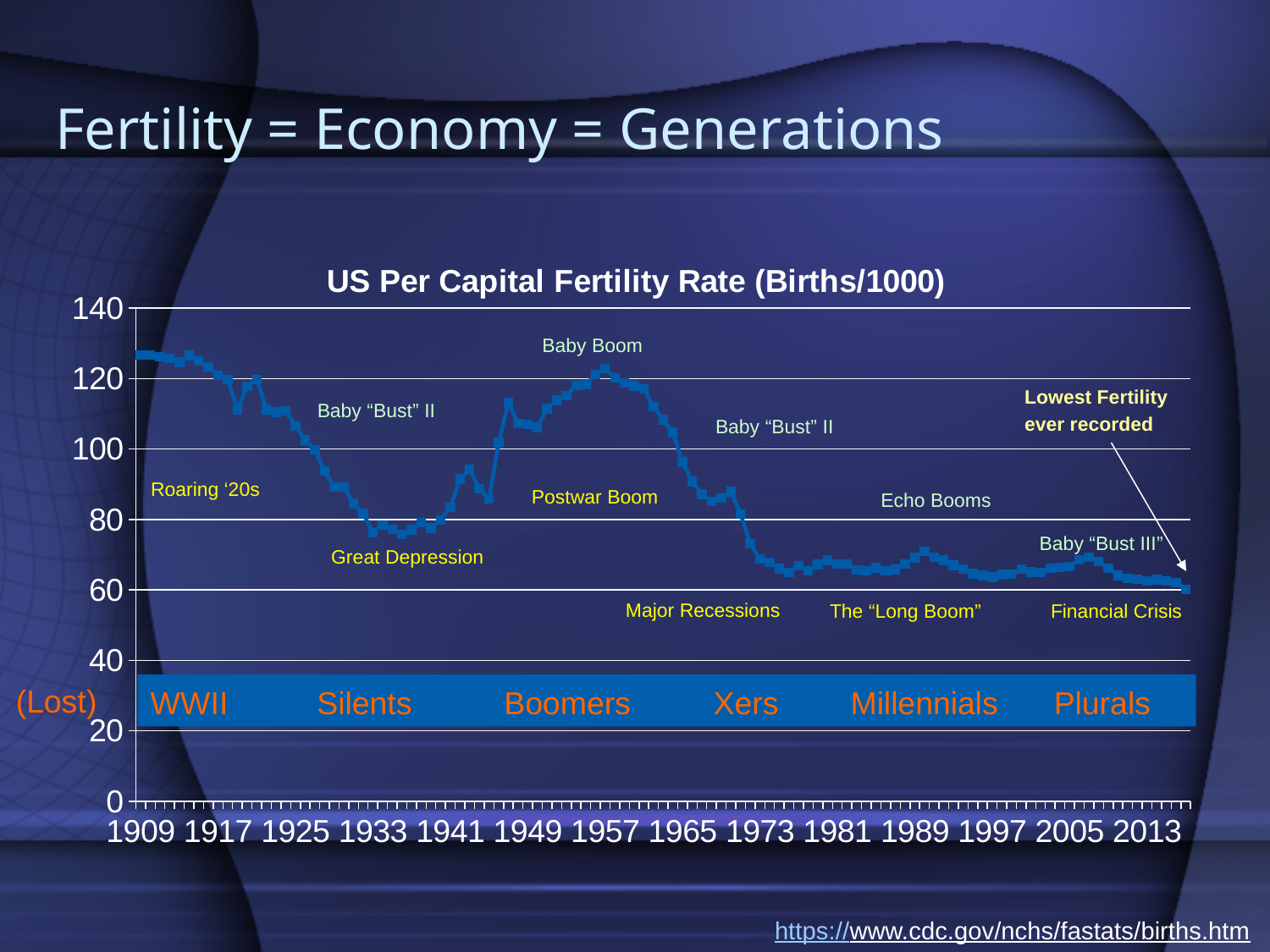
Which is larger, the fertility rate in 1957 or the fertility rate in 1973? 1957 Is the fertility rate at the Great Depression low point (around 1933-1936) greater or less than 80? less Which annotation labels the peak of the line around 1957? Baby Boom Does the fertility rate rise or fall between 1957 and 1973? fall What kind of chart is shown on the slide? line chart Is the fertility rate in 2013 greater or less than 80? less Does the fertility rate rise or fall between 1936 and 1957? rise Is the fertility rate in 1909 greater or less than 120? greater What is the title of the chart? US Per Capital Fertility Rate (Births/1000) Does the fertility rate rise or fall between 1909 and 1933? fall